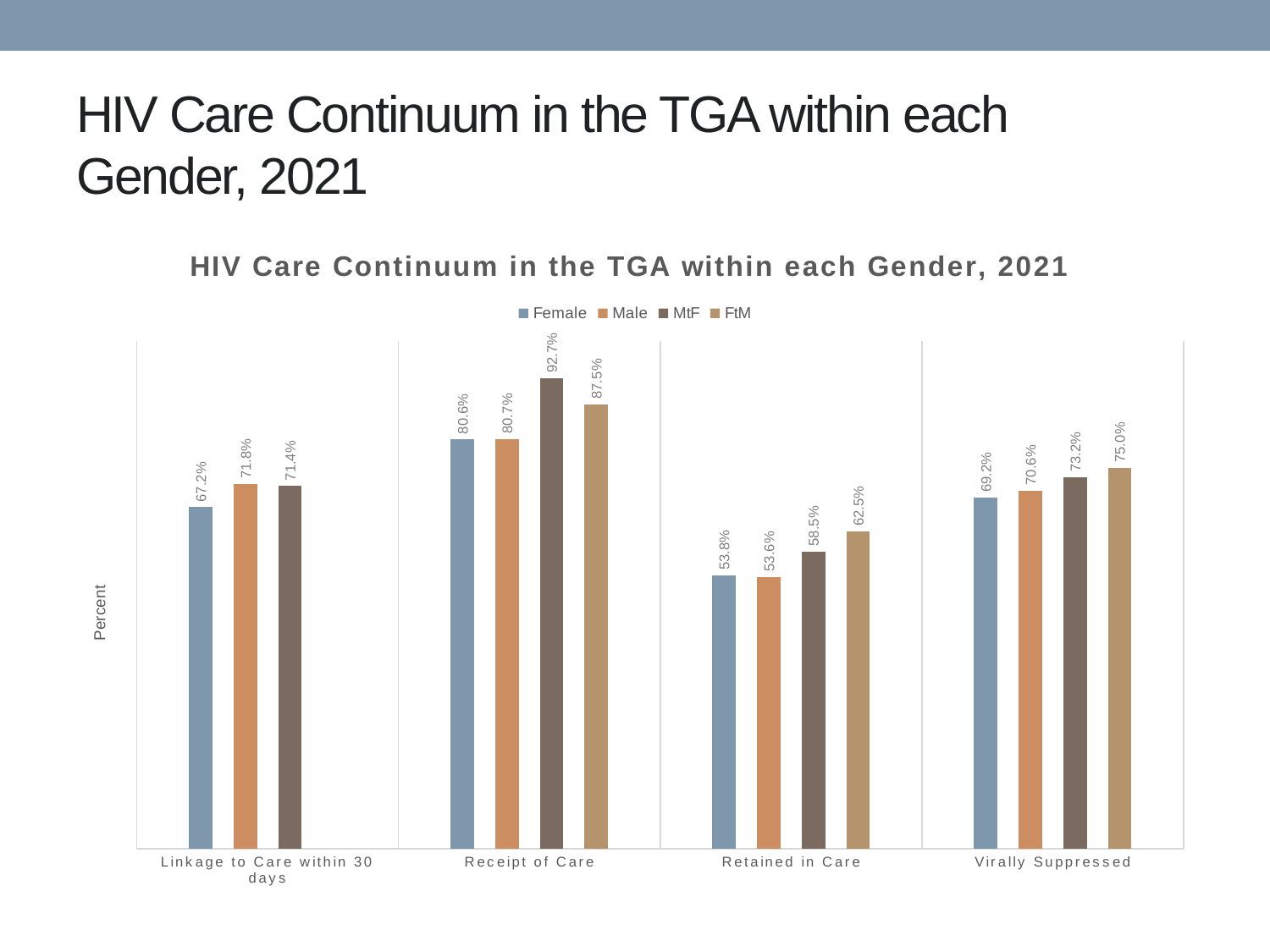
How many series does the legend list? 4 What is the MtF value for Retained in Care? 58.5% What is the Female value for Receipt of Care? 80.6% How many categories are shown on the x axis? 4 Which gender has the lowest value for Linkage to Care within 30 days? Female Which is larger for Virally Suppressed, the MtF value or the Female value? MtF What is the Male value for Linkage to Care within 30 days? 71.8% What kind of chart is shown on the slide? Bar chart What is the FtM value for Virally Suppressed? 75.0% What is the difference between the FtM and Female values for Retained in Care? 8.7% What is the label on the vertical axis? Percent Which gender has the highest value for Receipt of Care? MtF